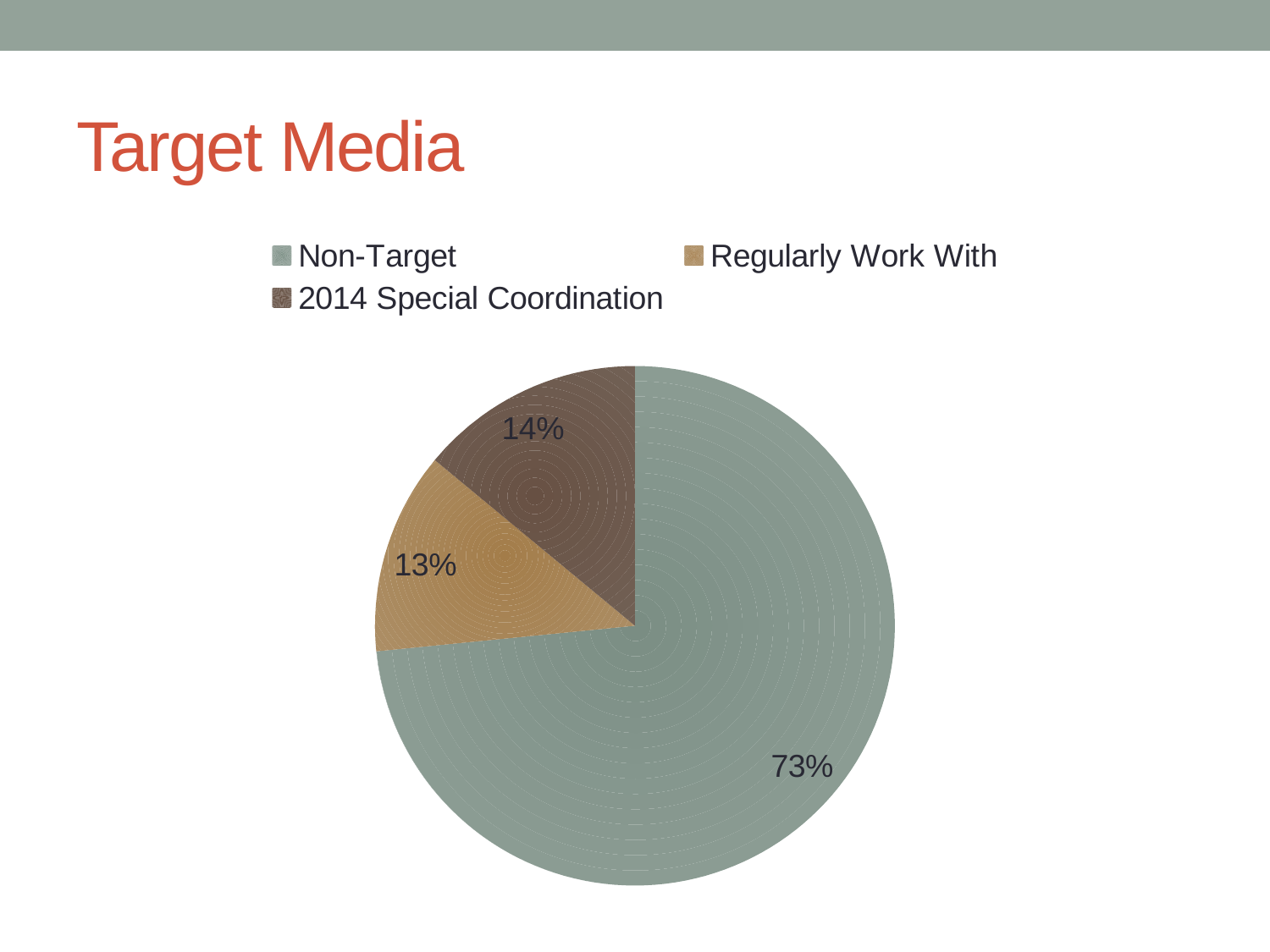
What is the difference in percentage points between Non-Target and 2014 Special Coordination? 59 What percentage of the pie is Non-Target? 73% Which category has the smallest share of the pie? Regularly Work With What is the combined share of Regularly Work With and 2014 Special Coordination? 27% What percentage of the pie is 2014 Special Coordination? 14% What is the title of the slide containing the pie chart? Target Media How many entries does the legend list? 3 Which category has the largest share of the pie? Non-Target How many slices does the pie chart have? 3 What kind of chart is shown on the slide? pie chart What percentage of the pie is Regularly Work With? 13% Which is larger, the share for 2014 Special Coordination or the share for Regularly Work With? 2014 Special Coordination